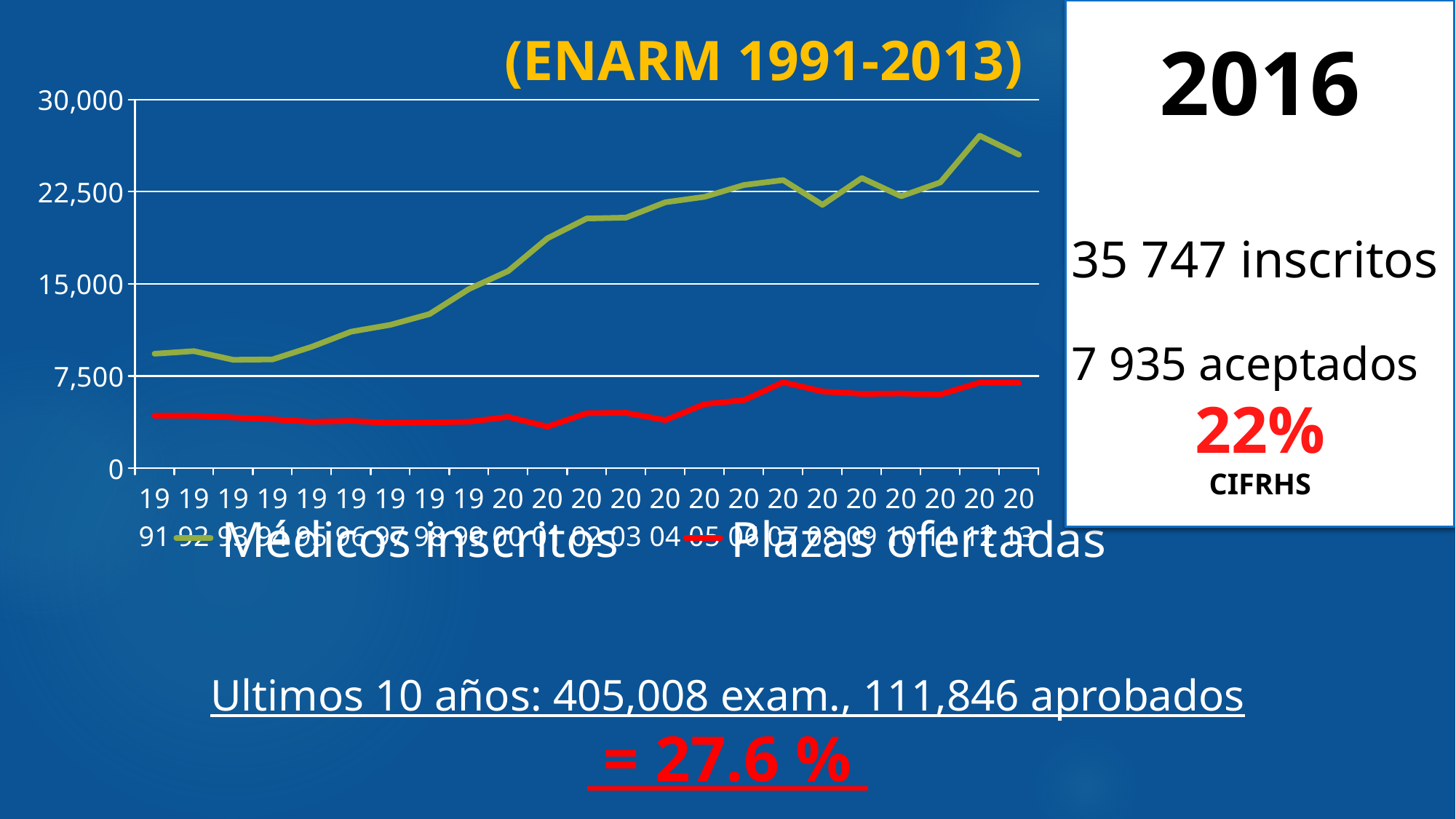
What is the title shown above the chart? (ENARM 1991-2013) How many series does the chart's legend list? 2 Is the value for Médicos inscritos in 2012 greater or less than 22,500? greater What kind of chart is shown on the slide? line chart What are the two series named in the chart's legend? Médicos inscritos and Plazas ofertadas Is the value for Plazas ofertadas in 2013 greater or less than 7,500? less Does the Médicos inscritos series generally rise or fall from 1991 to 2013? rise Which series has higher values throughout the chart, Médicos inscritos or Plazas ofertadas? Médicos inscritos Is the value for Médicos inscritos in 1991 greater or less than 15,000? less What is the highest value shown on the chart's vertical axis? 30,000 In which year does the Médicos inscritos series reach its highest value? 2012